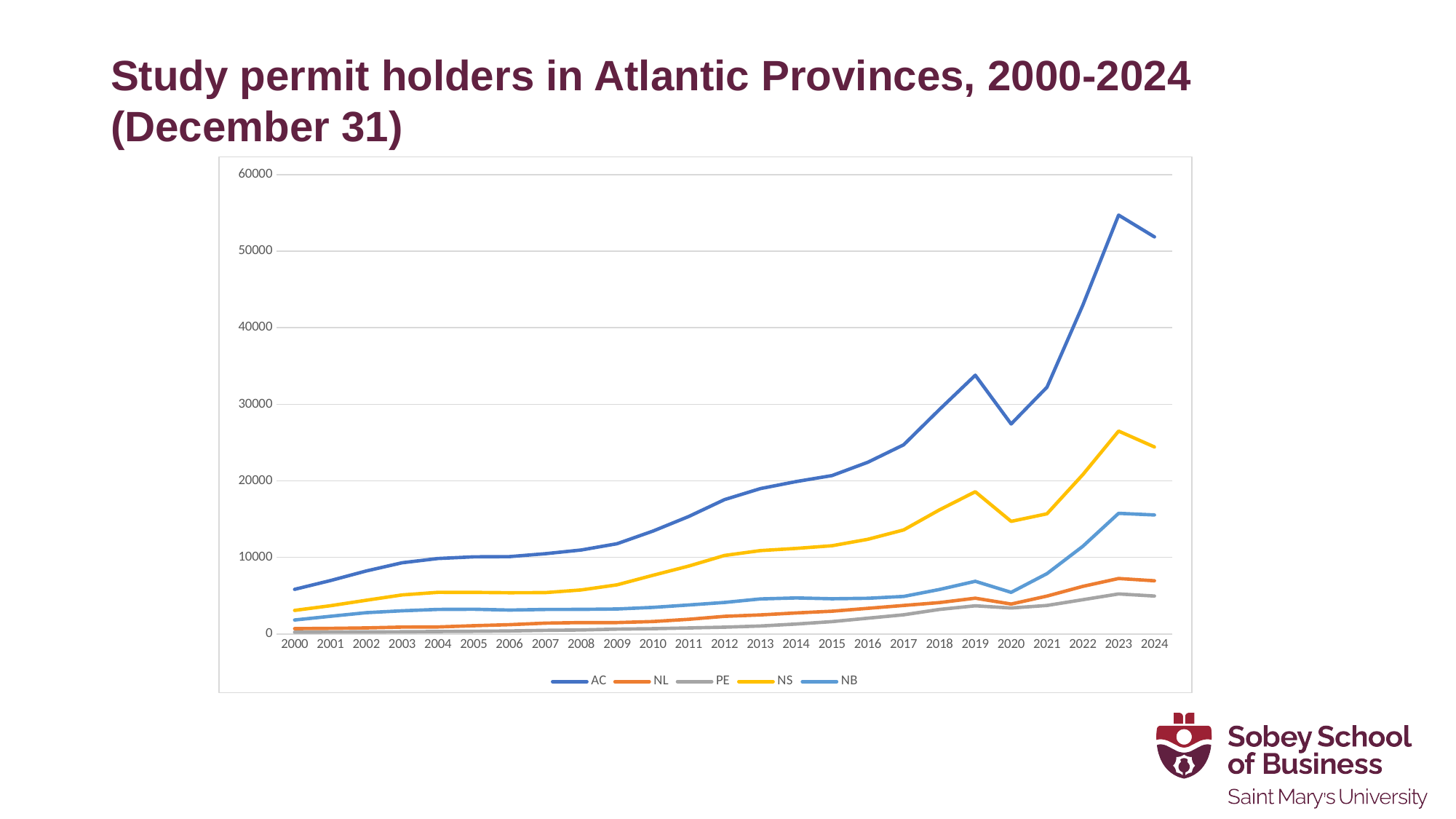
Is the value for NS in 2023 greater or less than 20000? greater Which series has the highest value in 2023? AC How many years are plotted along the x axis? 25 Is the value for AC in 2000 greater or less than 10000? less Does the AC line rise or fall between 2019 and 2020? fall In 2023, which is larger, the value for NS or the value for NB? NS What is the title of the chart on the slide? Study permit holders in Atlantic Provinces, 2000-2024 (December 31) Which series has the lowest value in 2023? PE Is the value for AC in 2023 greater or less than 50000? greater What kind of chart is shown on the slide? line chart How many series does the legend list? 5